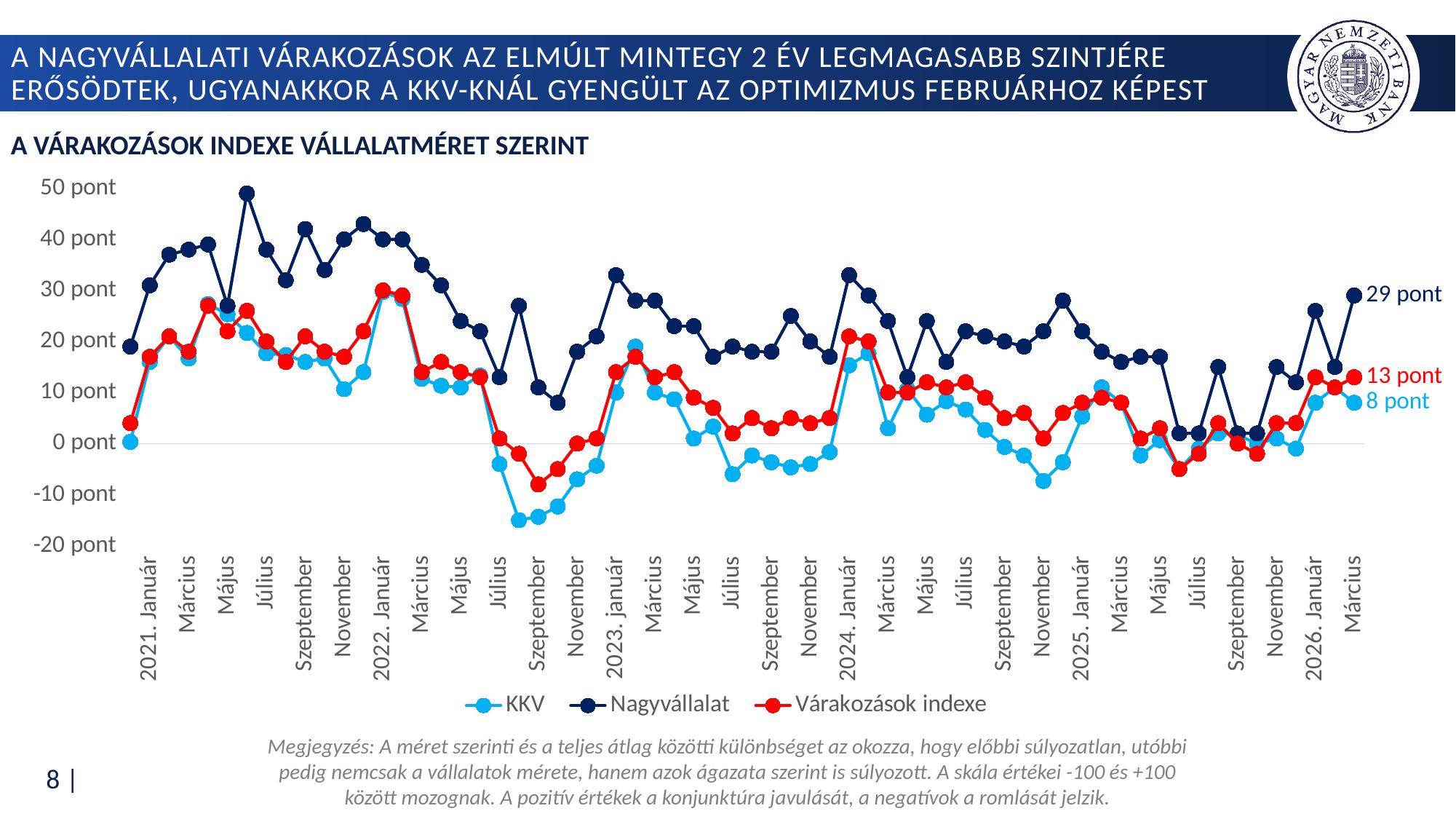
Which series has the lowest value at the last point (2026 Március)? KKV What is the value of the Várakozások indexe series at the last point (2026 Március)? 13 pont What is the value of the KKV series at the last point (2026 Március)? 8 pont Which series has the highest value at the last point (2026 Március)? Nagyvállalat Is the value for KKV in 2022 Szeptember greater or less than -10 pont? less At the last point (2026 Március), what is the difference between the Várakozások indexe value and the KKV value? 5 pont How many series does the legend list? 3 At the last point (2026 Március), which is larger: the Nagyvállalat value or the Várakozások indexe value? Nagyvállalat What kind of chart is shown on the slide? Line chart What is the value of the Nagyvállalat series at the last point (2026 Március)? 29 pont At the last point (2026 Március), what is the difference between the Nagyvállalat value and the KKV value? 21 pont